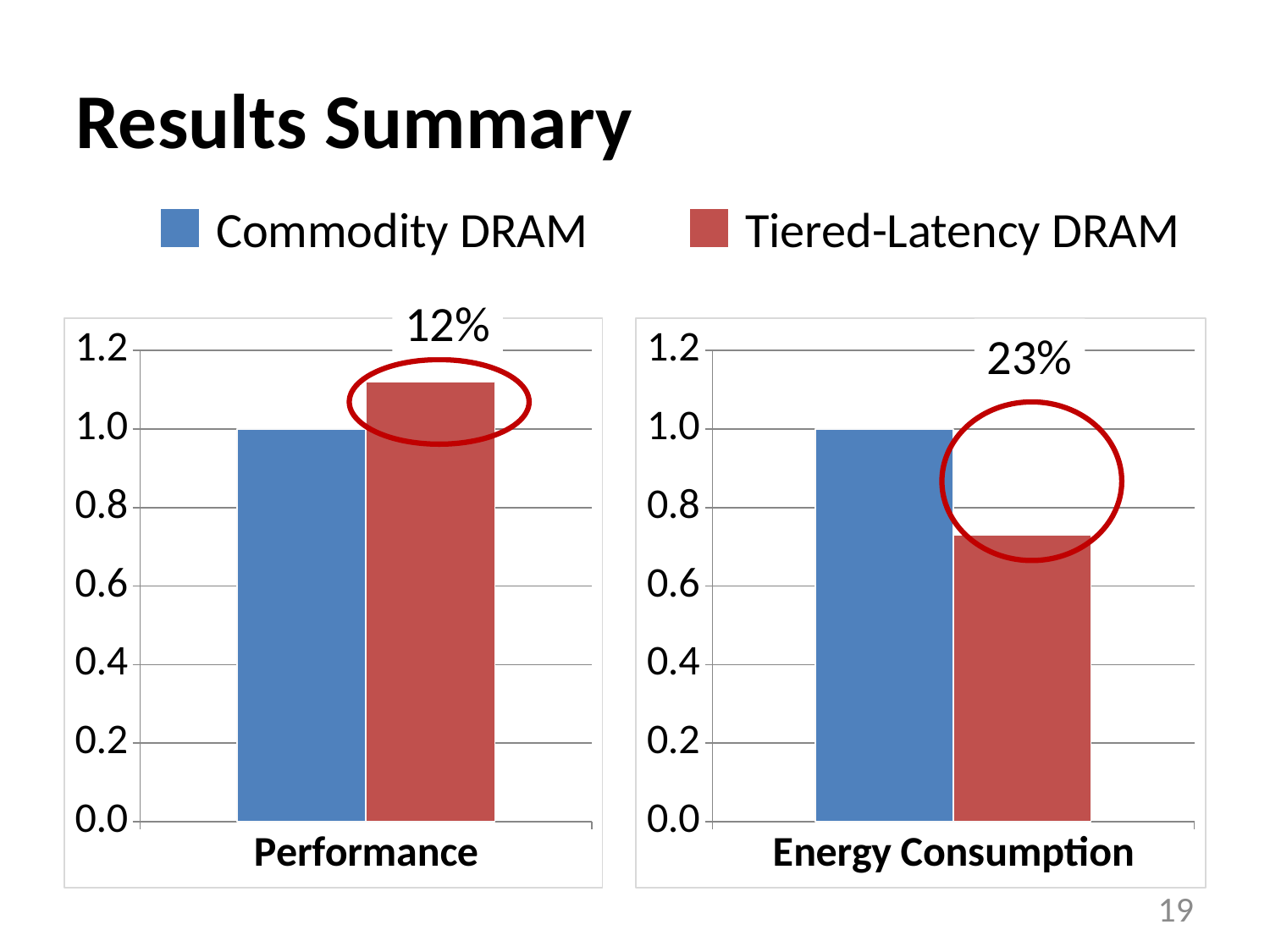
In the Energy Consumption chart, is the value for Tiered-Latency DRAM greater or less than 0.8? less In the Energy Consumption chart, is the value for Tiered-Latency DRAM greater or less than 0.6? greater In the Performance chart, what is the value for Commodity DRAM? 1.0 In the Energy Consumption chart, what is the value for Commodity DRAM? 1.0 How many series does the legend list? 2 In the Performance chart, is the value for Tiered-Latency DRAM greater or less than 1.2? less In the Performance chart, which series has the higher value? Tiered-Latency DRAM What percentage annotation is shown on the Performance chart? 12% What kind of chart is the Performance chart? bar chart In the Energy Consumption chart, which series has the lower value? Tiered-Latency DRAM What percentage annotation is shown on the Energy Consumption chart? 23%